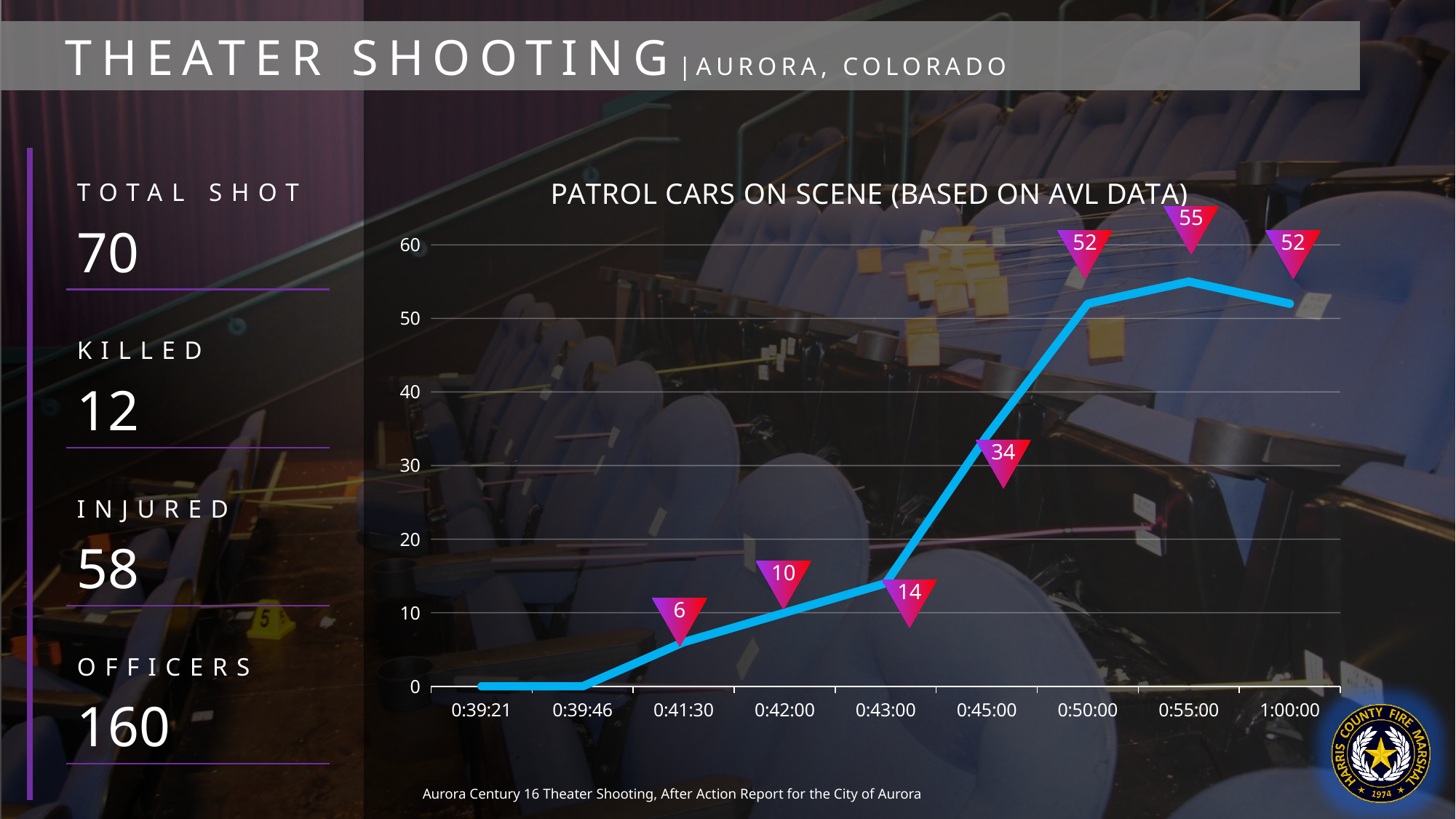
What is the difference between the number of patrol cars on scene at 0:50:00 and at 0:45:00? 18 What is the title of the chart? PATROL CARS ON SCENE (BASED ON AVL DATA) How many time points are plotted on the x axis? 9 Is the number of patrol cars on scene at 0:45:00 greater or less than 30? greater Which time had more patrol cars on scene, 0:42:00 or 0:43:00? 0:43:00 What is the difference between the number of patrol cars on scene at 0:55:00 and at 1:00:00? 3 What type of chart is shown on the slide? line chart How many patrol cars were on scene at 0:41:30? 6 How many patrol cars were on scene at 0:45:00? 34 How many patrol cars were on scene at 0:55:00? 55 At which time was the number of patrol cars on scene highest? 0:55:00 Does the number of patrol cars on scene rise or fall between 0:39:46 and 0:55:00? rise